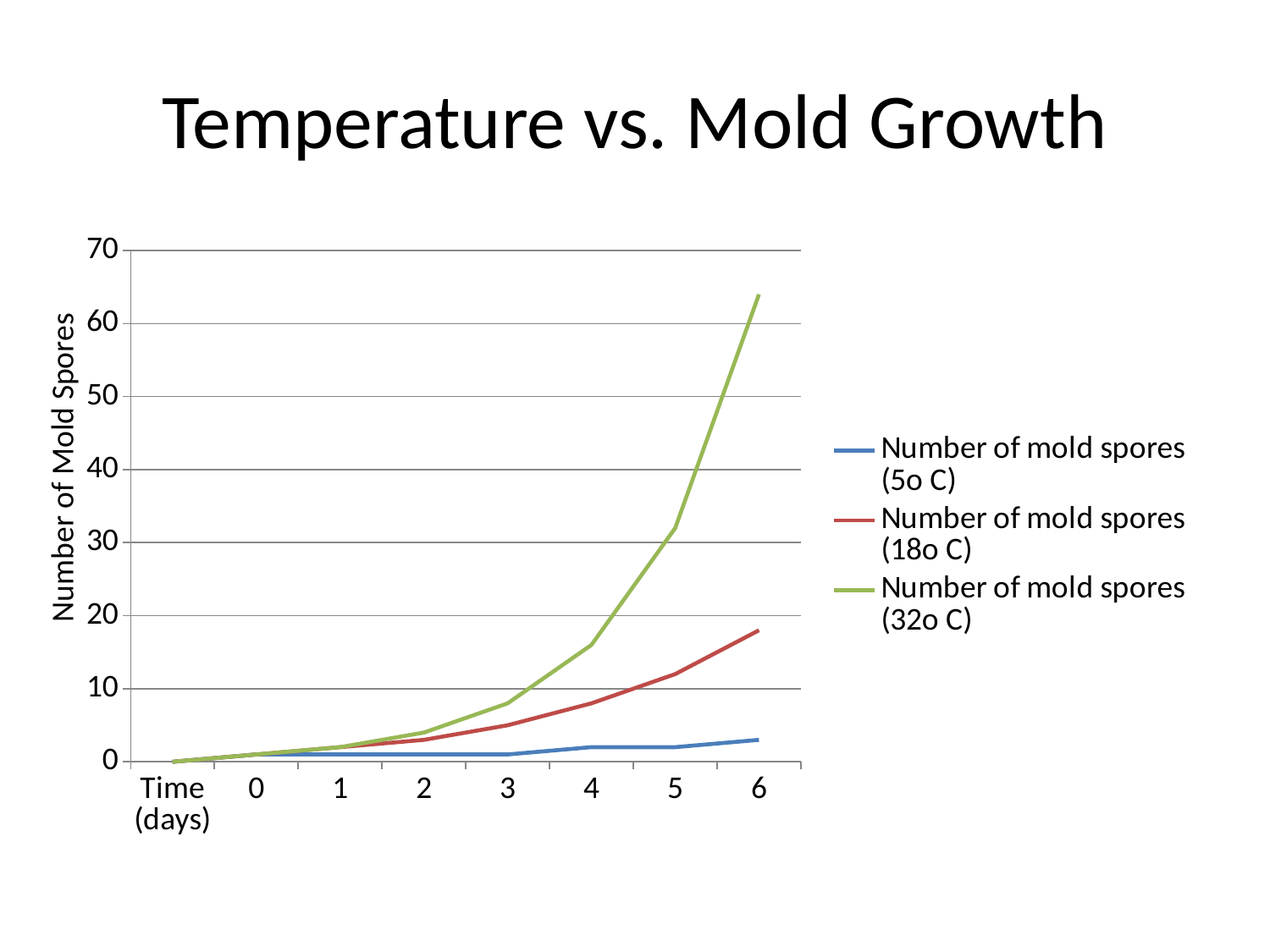
Is the value for Number of mold spores (5o C) at day 6 greater or less than 10? less What is the label on the vertical axis? Number of Mold Spores Is the value for Number of mold spores (32o C) at day 6 greater or less than 60? greater Is the value for Number of mold spores (32o C) at day 4 greater or less than 10? greater How many series does the legend list? 3 Does the Number of mold spores (32o C) series rise or fall as the days increase? rise Which series has the lowest value at day 6? Number of mold spores (5o C) What is the title of the chart? Temperature vs. Mold Growth At day 6, which is larger: Number of mold spores (32o C) or Number of mold spores (18o C)? Number of mold spores (32o C) What kind of chart is shown on the slide? line chart Which series has the highest value at day 6? Number of mold spores (32o C)